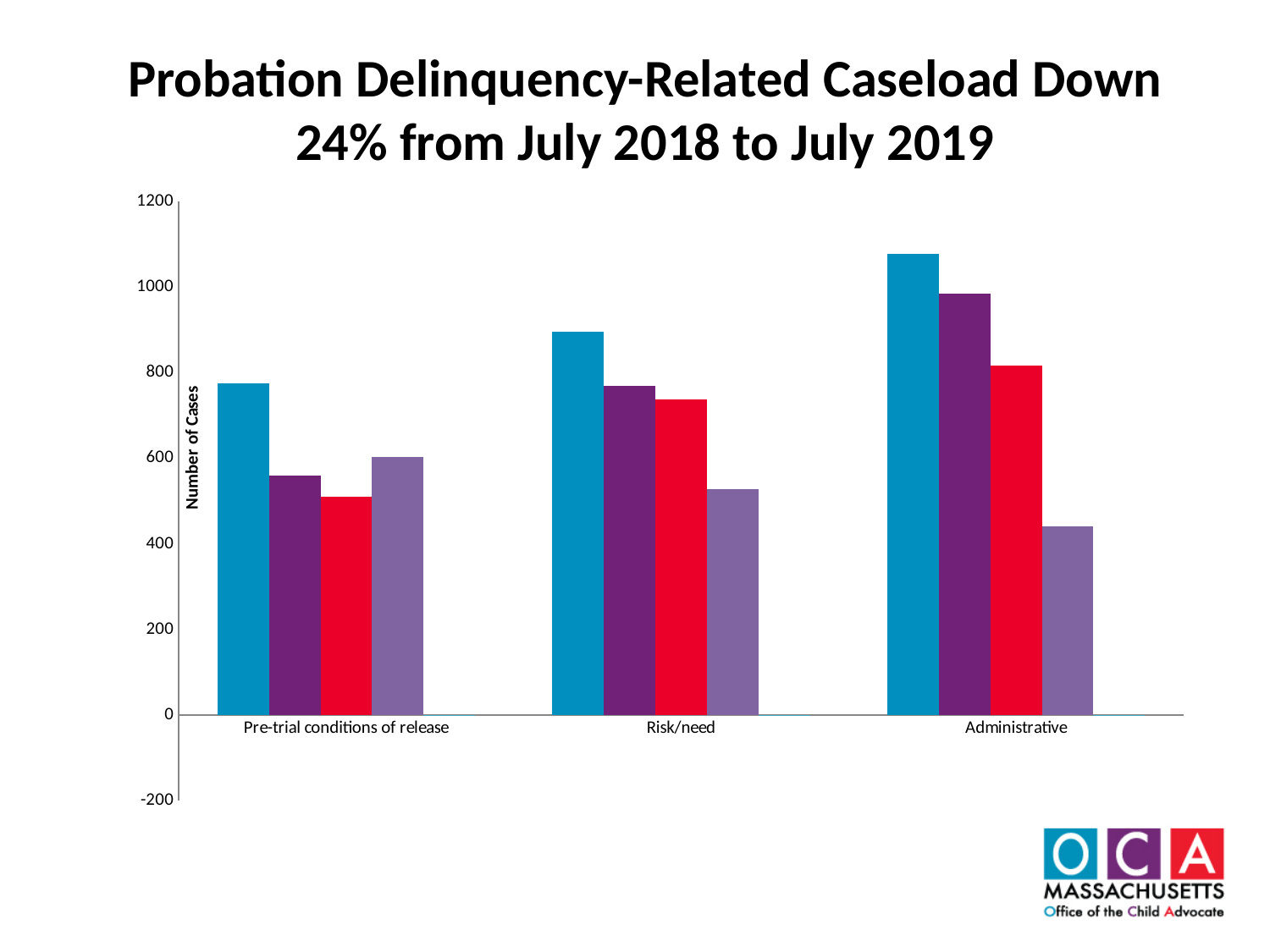
How many categories are shown on the x axis of the chart? 3 Is the value of the blue bar for Pre-trial conditions of release greater or less than 800? less Which category has the shortest light purple bar? Administrative Is the value of the light purple bar for Administrative greater or less than 600? less What kind of chart is shown on the slide? bar chart What is the title of the y axis of the chart? Number of Cases Is the value of the red bar for Risk/need greater or less than 600? greater For Pre-trial conditions of release, which is taller: the red bar or the light purple bar? the light purple bar Which category has the tallest blue bar? Administrative How many bars are plotted for each category in the chart? 4